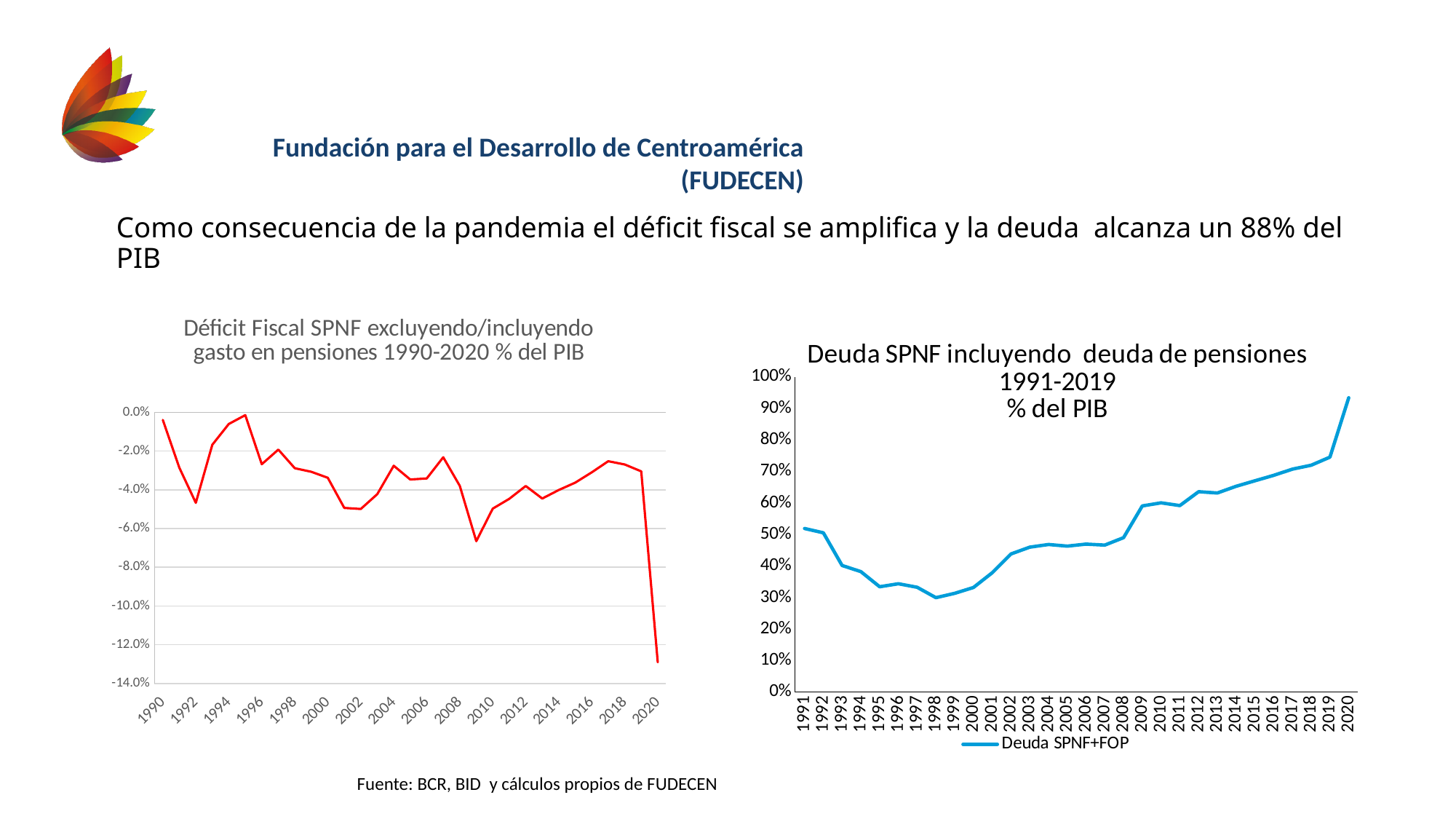
What kind of chart is the right chart, 'Deuda SPNF incluyendo deuda de pensiones'? Line chart In the right chart (Deuda SPNF incluyendo deuda de pensiones), do the values generally rise or fall from 1998 to 2020? Rise In the right chart (Deuda SPNF incluyendo deuda de pensiones), is the value for 2002 greater or less than 50%? less What is the legend entry shown below the right chart (Deuda SPNF incluyendo deuda de pensiones)? Deuda SPNF+FOP In the right chart (Deuda SPNF incluyendo deuda de pensiones), which is larger, the value for 1991 or the value for 2020? 2020 In the left chart (Déficit Fiscal SPNF), which year has the lowest value? 2020 What kind of chart is the left chart, 'Déficit Fiscal SPNF excluyendo/incluyendo gasto en pensiones 1990-2020 % del PIB'? Line chart In the left chart (Déficit Fiscal SPNF), is the value for 2020 greater or less than -12.0%? less In the left chart (Déficit Fiscal SPNF), is the value for 2009 greater or less than -6.0%? less In the right chart (Deuda SPNF incluyendo deuda de pensiones), which year has the highest value? 2020